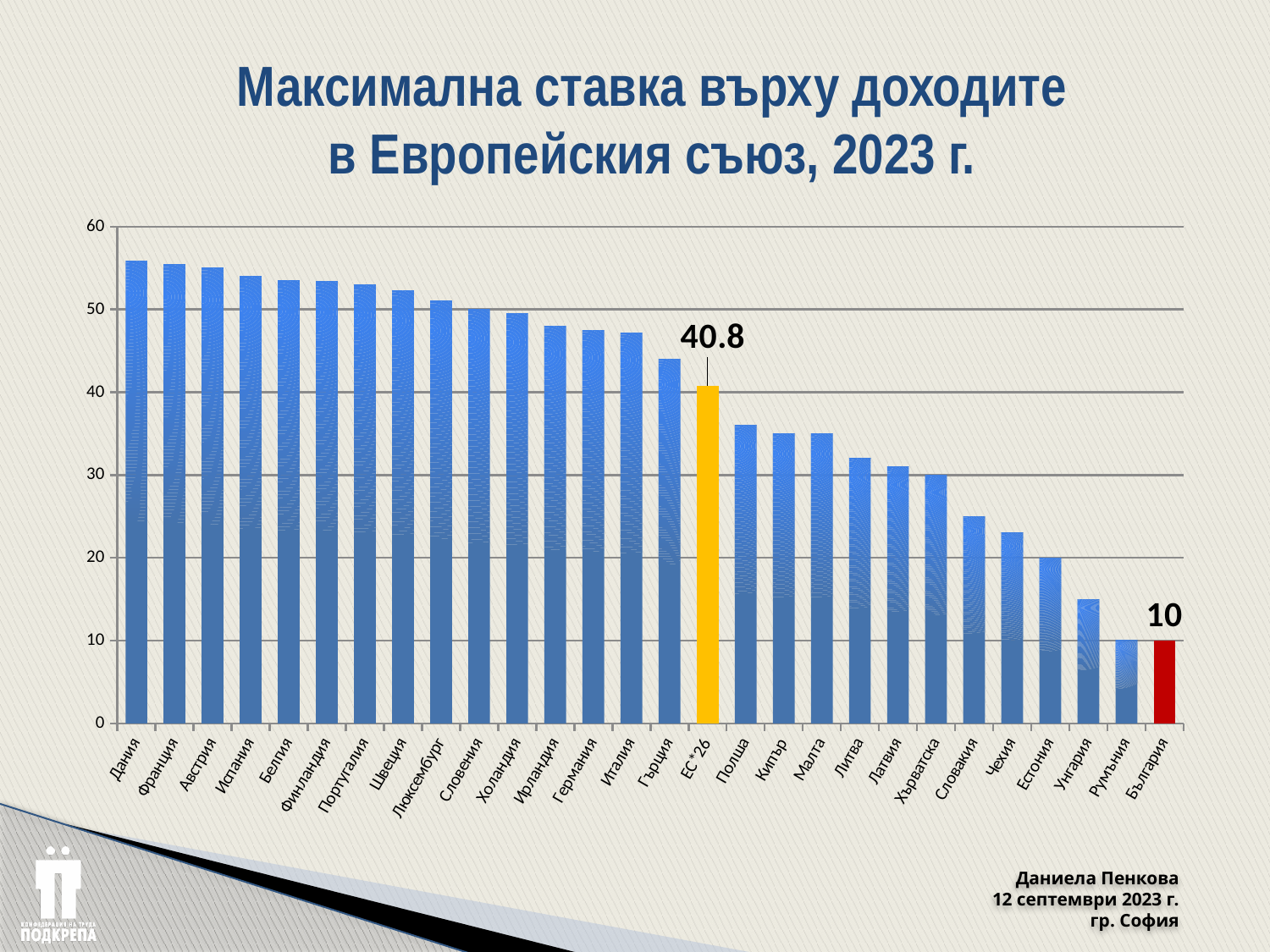
Is the value for Унгария greater or less than 20? less Which is larger, the value for Полша or the value for Литва? Полша Is the value for Словакия greater or less than 30? less What is the value shown for България? 10 What is the difference between the value for ЕС*26 and the value for България? 30.8 What colour is the bar for България? red How many bars are plotted in the chart? 28 What kind of chart is shown on the slide? bar chart Is the value for Гърция greater or less than 50? less What is the value shown for ЕС*26? 40.8 Which is larger, the value for ЕС*26 or the value for България? ЕС*26